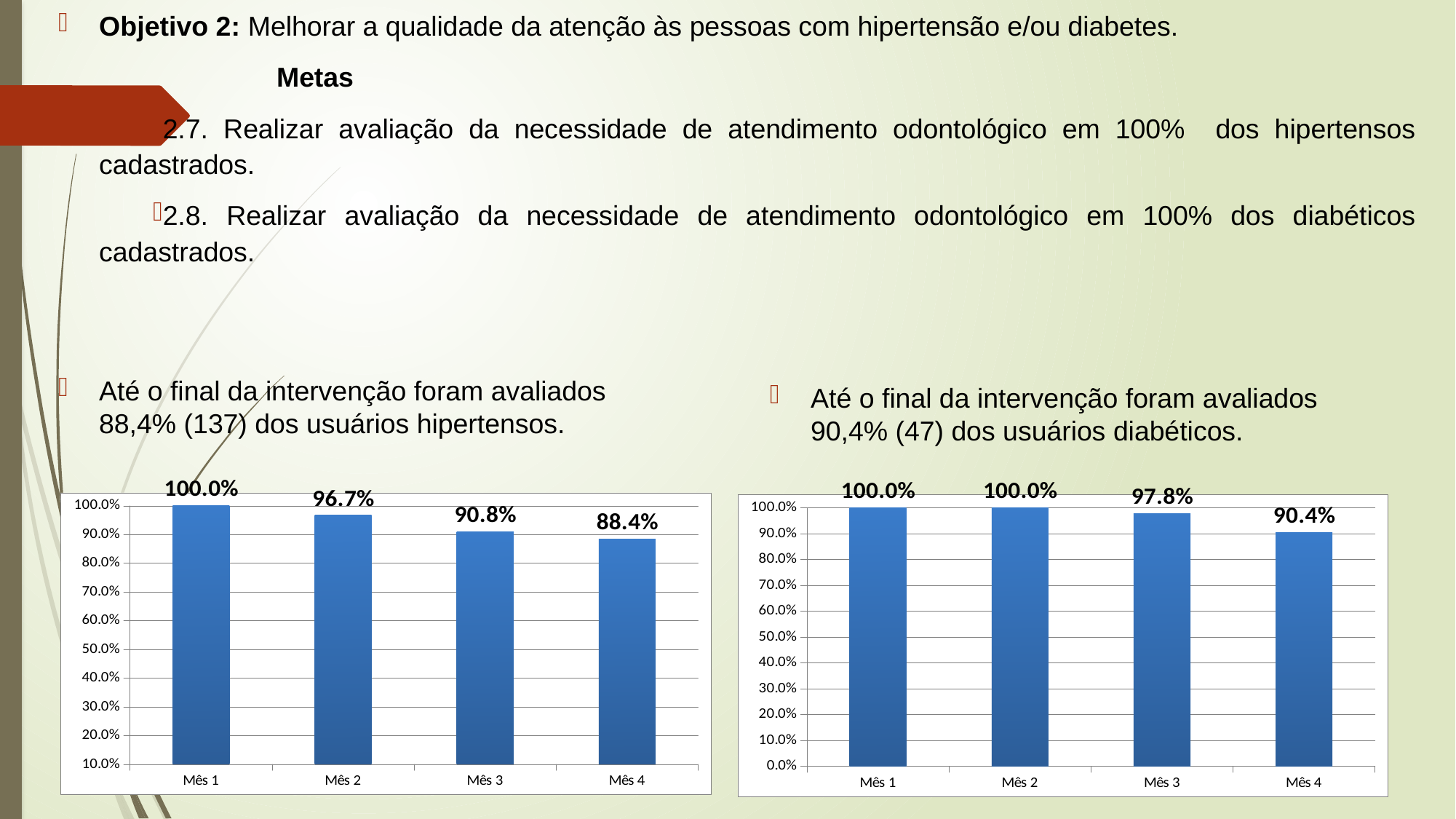
In the left chart (hipertensos), which month has the lowest value? Mês 4 In the right chart (diabéticos), what is the value for Mês 4? 90.4% How many months (categories) are shown in the right chart (diabéticos)? 4 In the left chart (hipertensos), which is larger, the value for Mês 2 or the value for Mês 3? Mês 2 In the right chart (diabéticos), which month has the lowest value? Mês 4 In the left chart (hipertensos), what is the difference between the values for Mês 1 and Mês 4? 11.6% What kind of chart is the left chart (hipertensos)? Bar chart In the left chart (hipertensos), what is the value for Mês 4? 88.4% In the left chart (hipertensos), do the values rise or fall from Mês 1 to Mês 4? Fall In the left chart (hipertensos), what is the value for Mês 2? 96.7% In the right chart (diabéticos), what is the difference between the values for Mês 3 and Mês 4? 7.4% In the right chart (diabéticos), what is the value for Mês 3? 97.8%